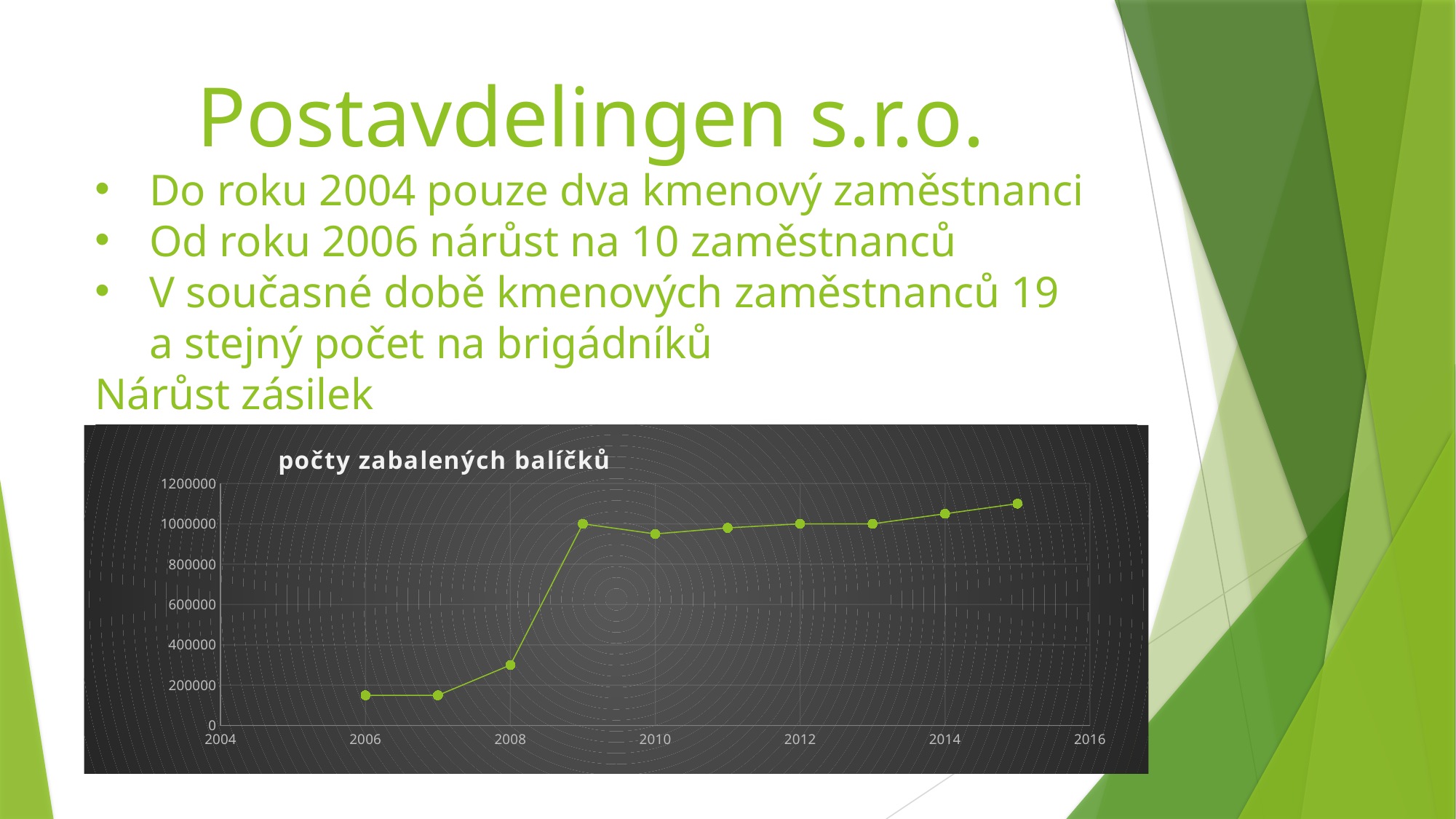
Which year has the larger value, 2010 or 2015? 2015 What type of chart is shown on the slide? line chart Which year has the larger value, 2008 or 2009? 2009 What is the title of the chart? počty zabalených balíčků Is the value for 2015 greater or less than 1000000? greater Is the value for 2010 greater or less than 600000? greater Is the value for 2006 greater or less than 200000? less Do the values generally rise or fall from 2006 to 2015? rise In which year is the value highest? 2015 How many data points are plotted on the line? 10